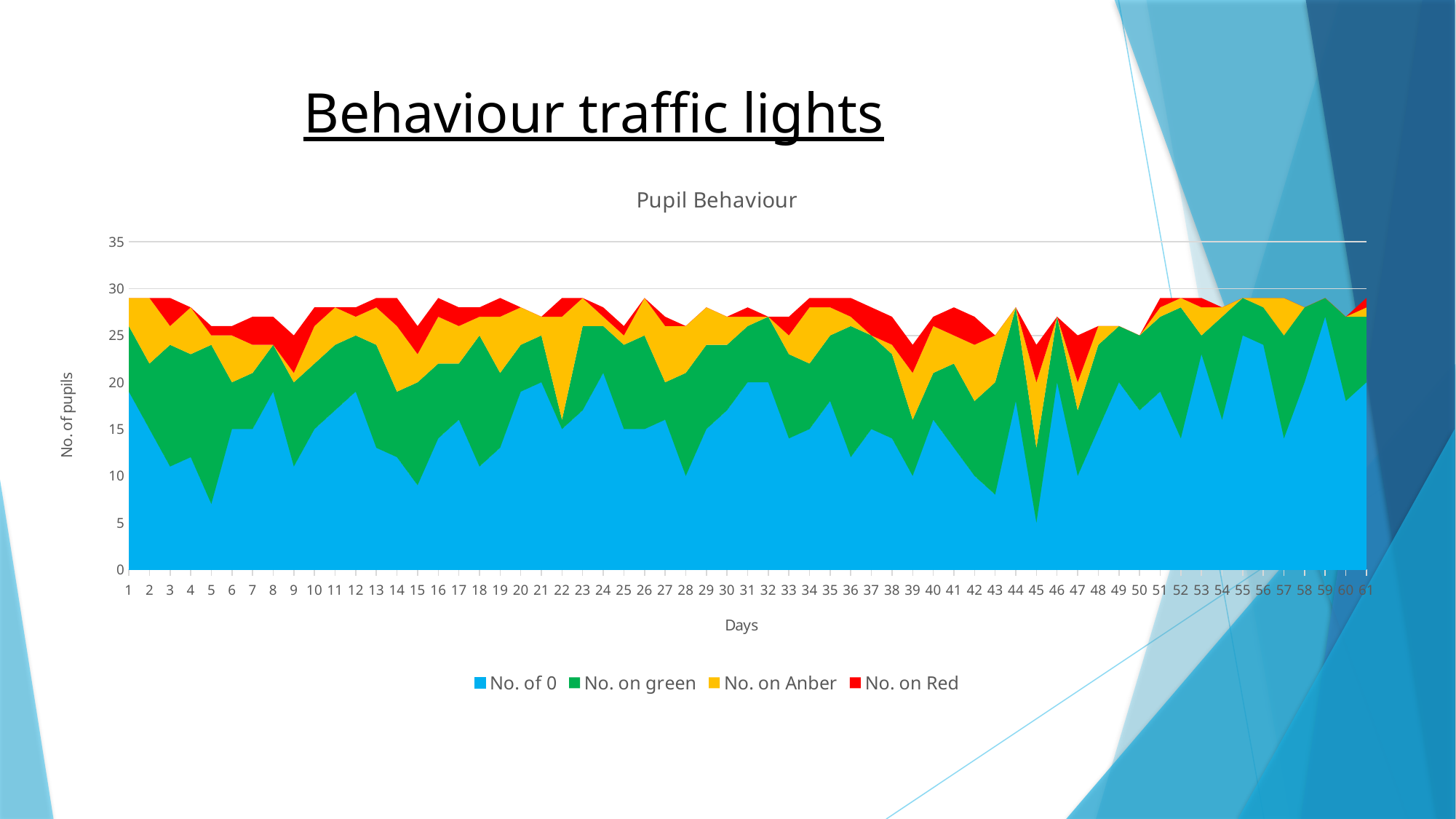
Is the value for 'No. of 0' on day 45 greater or less than 10? less Is the total stacked value on day 1 greater or less than 25? greater What is the title of the chart? Pupil Behaviour On which day is the value for 'No. of 0' lowest? 45 How many series does the legend list? 4 How many days are plotted along the x axis? 61 Is the value for 'No. of 0' on day 5 greater or less than 10? less What kind of chart is shown on the slide? Stacked area chart Which series occupies the largest area of the chart? No. of 0 What is the label of the y axis? No. of pupils